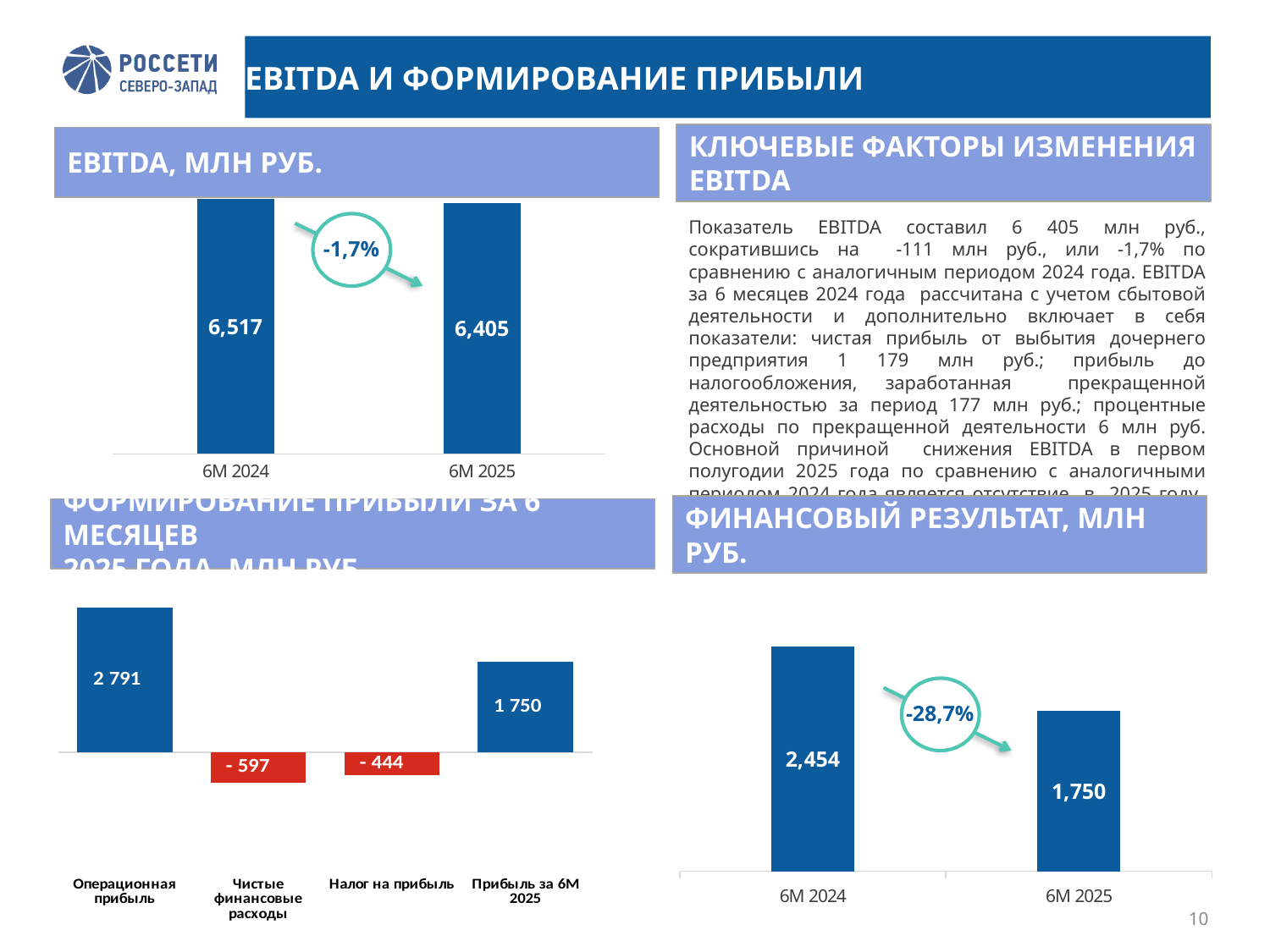
In the 'ФИНАНСОВЫЙ РЕЗУЛЬТАТ, МЛН РУБ.' chart, what is the value for 6M 2025? 1,750 In the 'ФИНАНСОВЫЙ РЕЗУЛЬТАТ, МЛН РУБ.' chart, what is the value for 6M 2024? 2,454 In the 'ФОРМИРОВАНИЕ ПРИБЫЛИ ЗА 6 МЕСЯЦЕВ 2025 ГОДА' chart (bottom left), what is the value for Операционная прибыль? 2 791 What type of chart is the 'ФИНАНСОВЫЙ РЕЗУЛЬТАТ, МЛН РУБ.' chart? Bar chart In the 'EBITDA, МЛН РУБ.' chart, what percentage change is shown between 6M 2024 and 6M 2025? -1,7% In the 'EBITDA, МЛН РУБ.' chart, what is the value for 6M 2025? 6,405 In the 'ФОРМИРОВАНИЕ ПРИБЫЛИ ЗА 6 МЕСЯЦЕВ 2025 ГОДА' chart (bottom left), how many categories are shown? 4 In the 'ФОРМИРОВАНИЕ ПРИБЫЛИ ЗА 6 МЕСЯЦЕВ 2025 ГОДА' chart (bottom left), what is the value for Налог на прибыль? - 444 In the 'EBITDA, МЛН РУБ.' chart, what is the value for 6M 2024? 6,517 In the 'ФОРМИРОВАНИЕ ПРИБЫЛИ ЗА 6 МЕСЯЦЕВ 2025 ГОДА' chart (bottom left), which category has the highest value? Операционная прибыль In the 'ФОРМИРОВАНИЕ ПРИБЫЛИ ЗА 6 МЕСЯЦЕВ 2025 ГОДА' chart (bottom left), what is the value for Чистые финансовые расходы? - 597 In the 'EBITDA, МЛН РУБ.' chart, which period has the higher value? 6M 2024